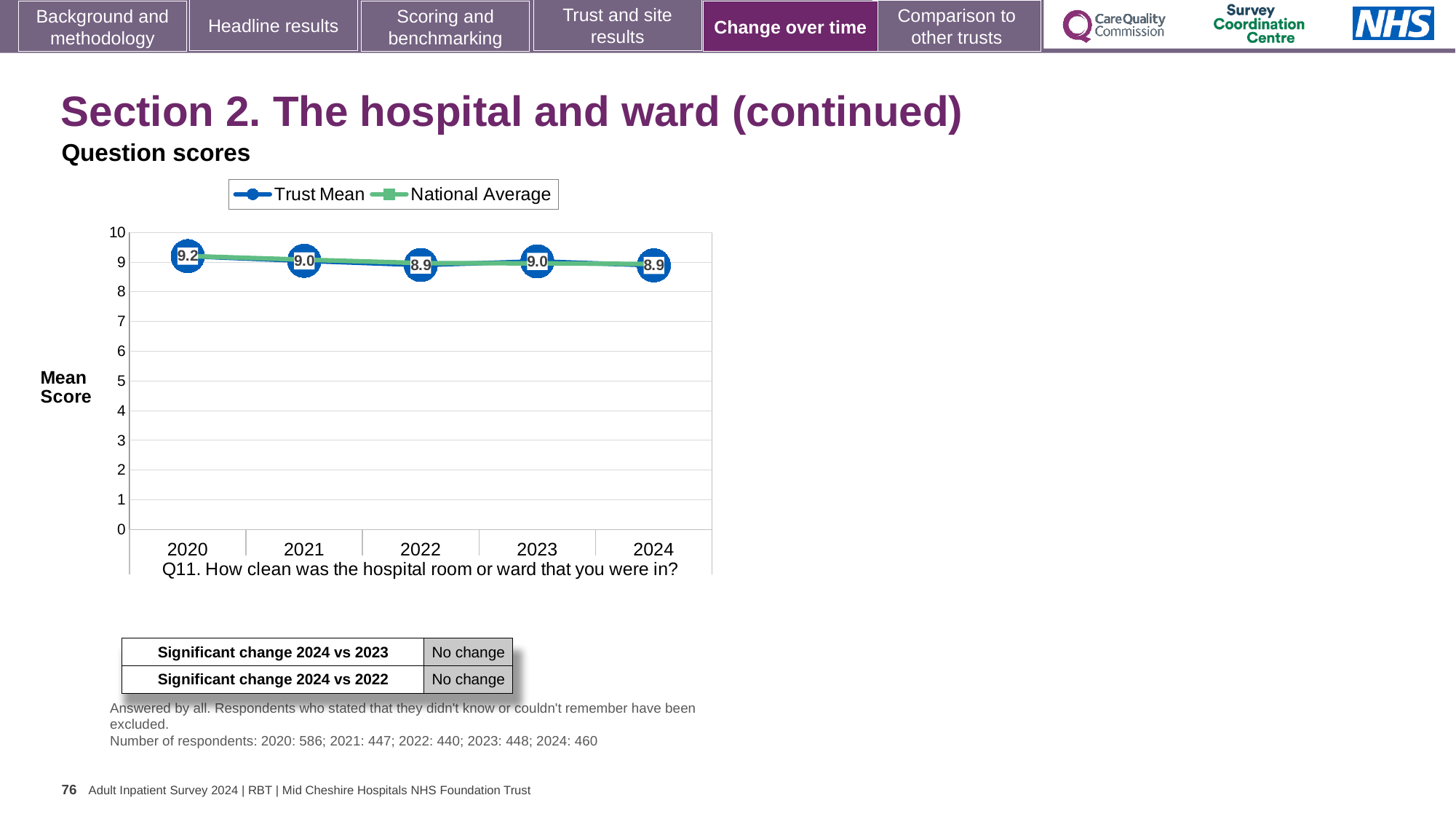
What is the difference between the Trust Mean score in 2020 and in 2024? 0.3 How many years are shown on the x axis of the chart? 5 Which question does the chart show scores for? Q11. How clean was the hospital room or ward that you were in? Is the Trust Mean score for 2023 greater or less than 8? greater What is the Trust Mean score for 2023? 9.0 What is the Trust Mean score for 2020? 9.2 What is the Trust Mean score for 2024? 8.9 What is the Trust Mean score for 2022? 8.9 Is the Trust Mean score for 2021 larger than the Trust Mean score for 2022? Yes, 2021 (9.0) is larger than 2022 (8.9) What kind of chart is shown on the slide? Line chart How many series does the chart legend list? 2 In which year is the Trust Mean score highest? 2020